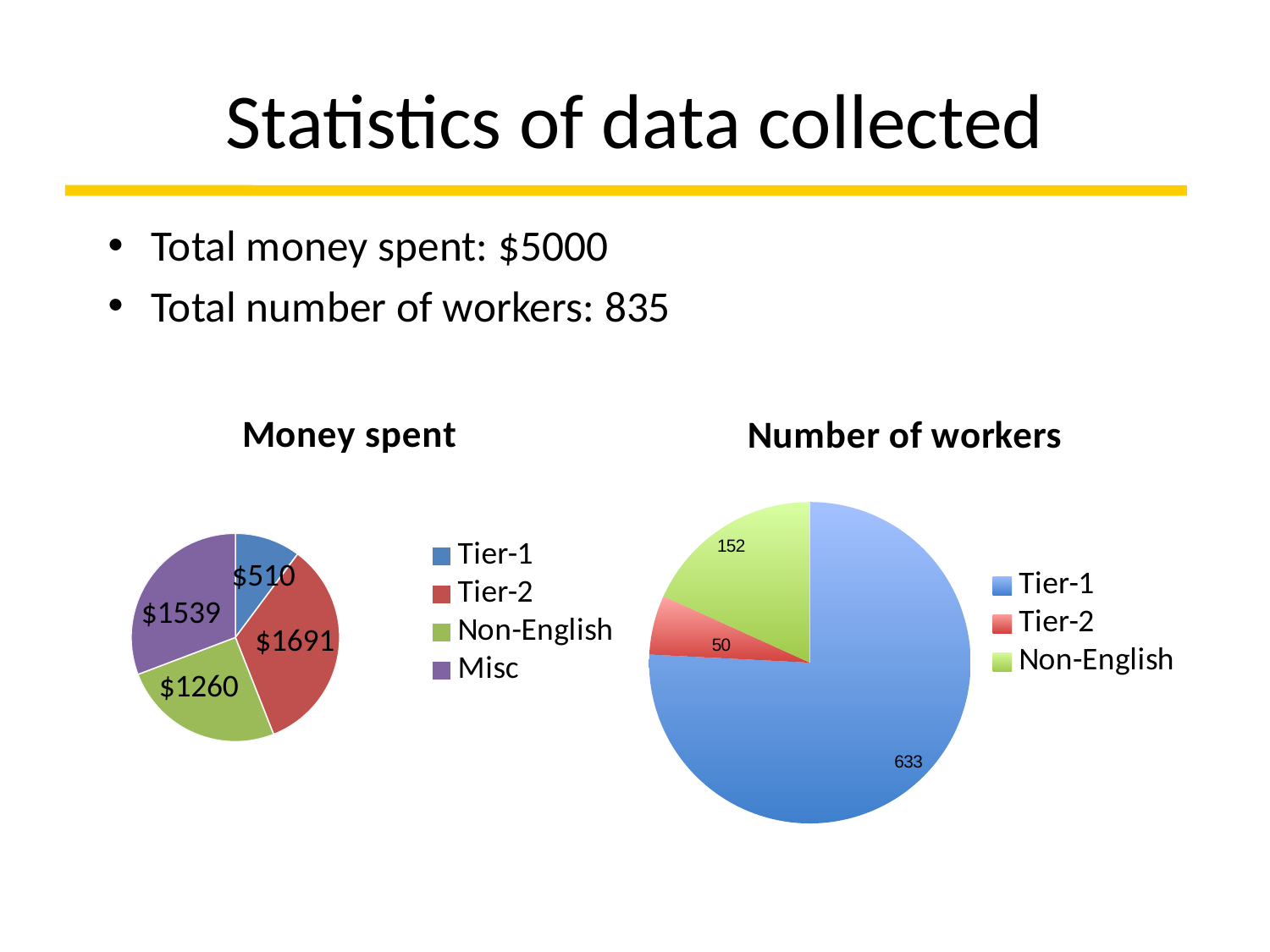
In the Money spent chart, which is larger: Non-English or Misc? Misc In the Money spent chart, which category has the smallest amount? Tier-1 In the Number of workers chart, how many workers are in Tier-1? 633 In the Money spent chart, how much was spent on Tier-2? $1691 In the Number of workers chart, how many Non-English workers are there? 152 How many slices does the Number of workers pie chart have? 3 In the Money spent chart, how much was spent on Misc? $1539 In the Money spent chart, what share of the total does Tier-1 represent? 10.2% In the Money spent chart, which category has the largest amount? Tier-2 In the Number of workers chart, which category has the fewest workers? Tier-2 In the Money spent chart, what is the difference between the Tier-2 and Tier-1 amounts? $1181 In the Number of workers chart, how many more workers are Non-English than Tier-2? 102